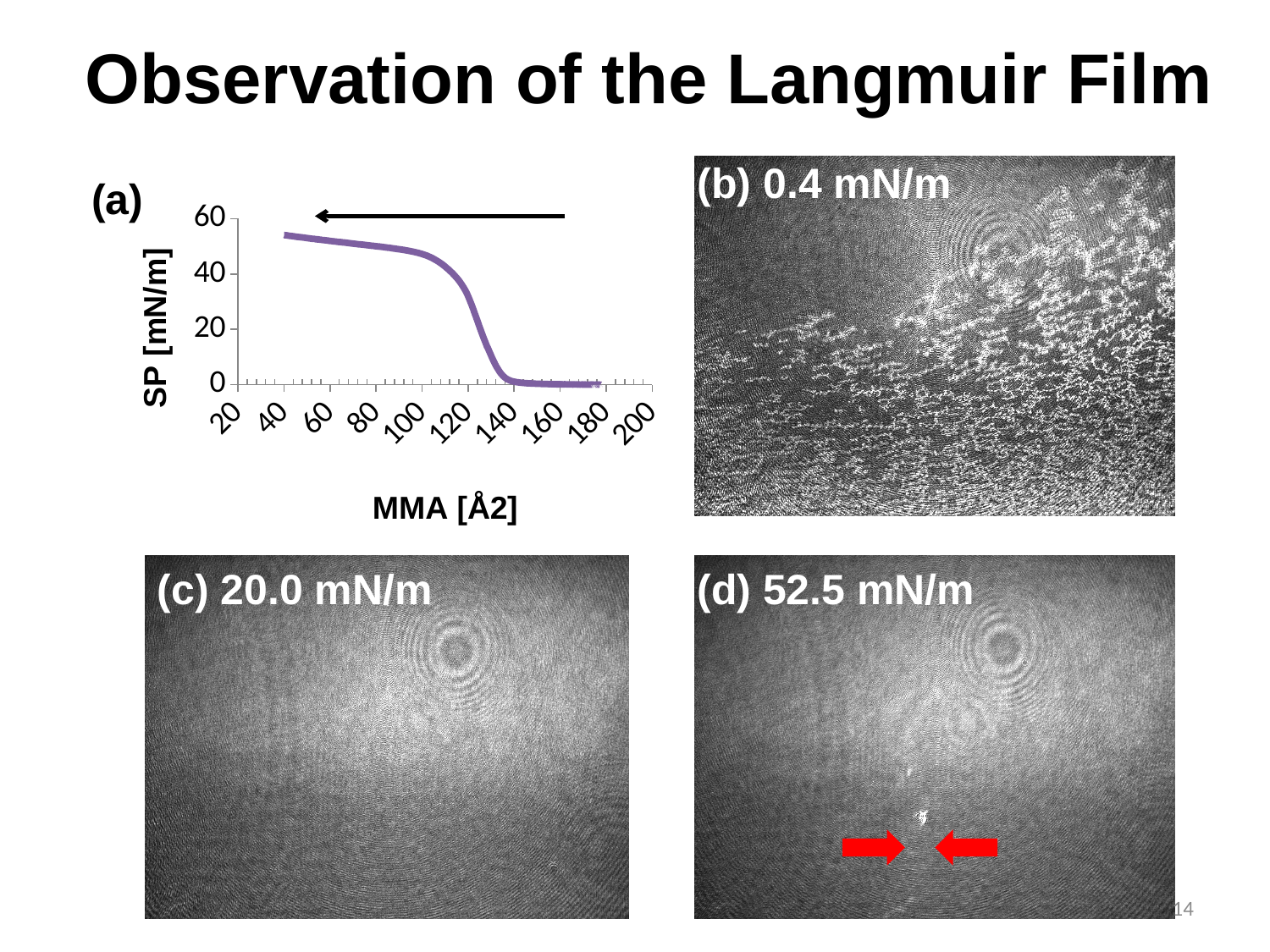
What is the label of the y axis in chart (a)? SP [mN/m] In chart (a), is the SP value at MMA 180 greater or less than 20 mN/m? less In chart (a), is the SP value at MMA 160 greater or less than 20 mN/m? less What is the label of the x axis in chart (a)? MMA [Å2] In chart (a), is the SP value at MMA 40 larger or smaller than the SP value at MMA 160? larger In chart (a), is the SP value at MMA 40 greater or less than 40 mN/m? greater In chart (a), does SP rise or fall as MMA increases along the x axis? fall What kind of chart is chart (a) on the slide? line chart